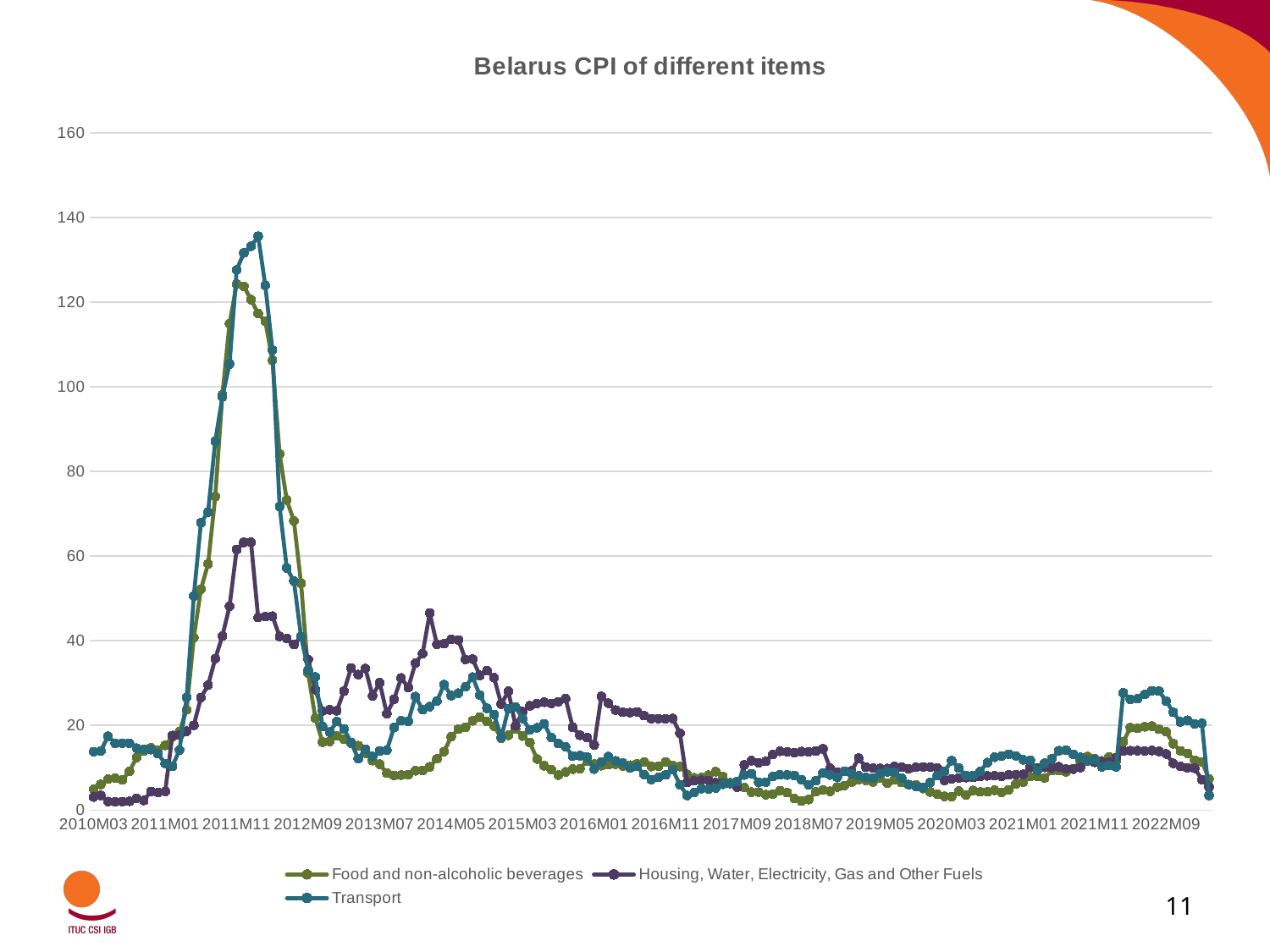
What colour is the line for the Transport series? teal Is the peak value of the Food and non-alcoholic beverages series greater or less than 100? greater Which series reaches the highest peak on the chart? Transport Which series has the lowest peak during the 2011 spike? Housing, Water, Electricity, Gas and Other Fuels Is the Transport value at 2010M03 greater or less than 20? less What is the title of the chart? Belarus CPI of different items What kind of chart is shown on the slide? line chart Around 2014M05, which series is higher: Housing, Water, Electricity, Gas and Other Fuels or Food and non-alcoholic beverages? Housing, Water, Electricity, Gas and Other Fuels Between the 2011M11 peak and 2012M09, do the values of the Transport series rise or fall? fall Is the peak value of the Housing, Water, Electricity, Gas and Other Fuels series greater or less than 80? less How many series does the legend list? 3